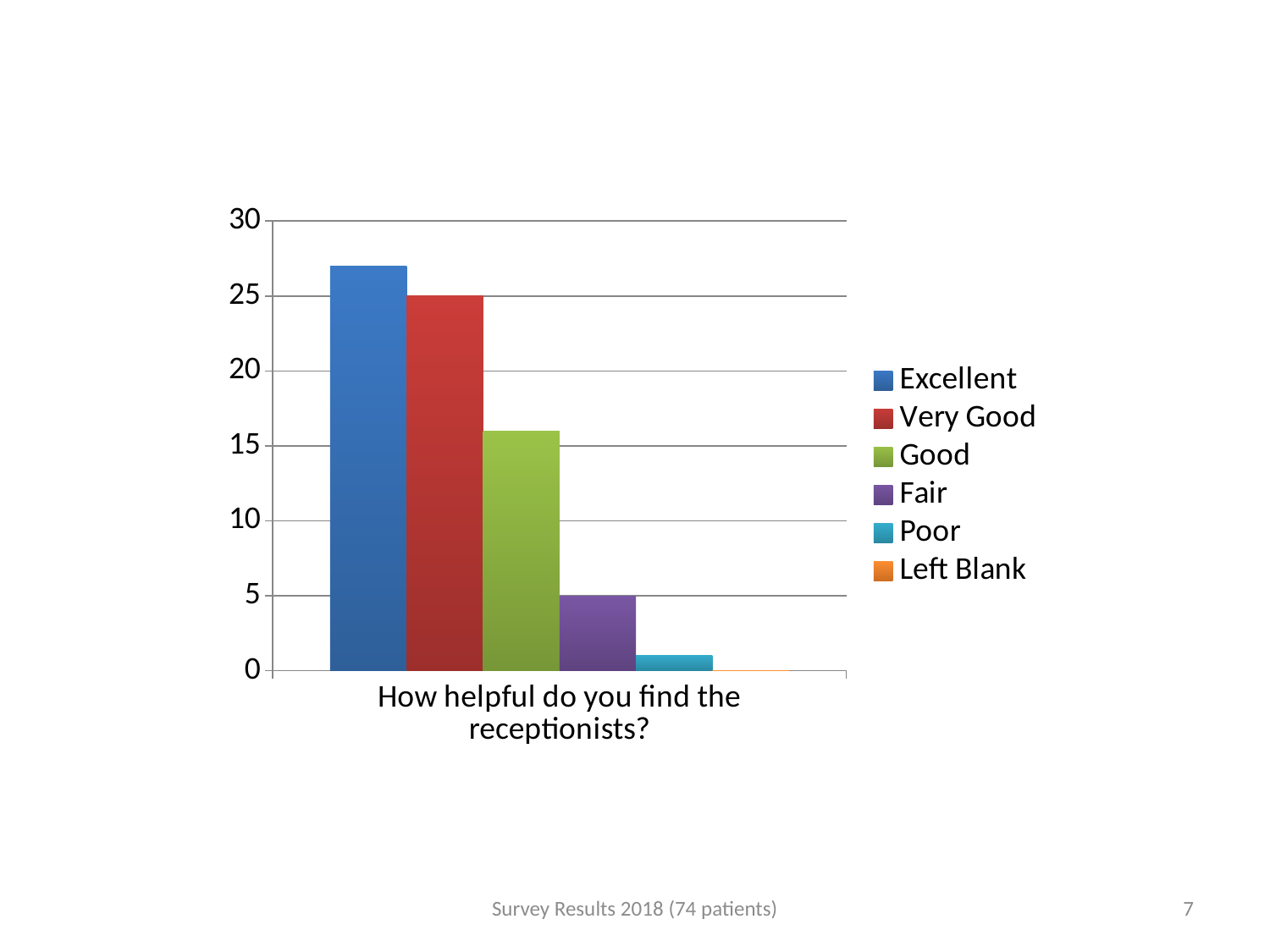
Which category has the highest value? Excellent What is the value for Fair? 5 Which is larger, the value for Excellent or the value for Very Good? Excellent Is the value for Excellent greater or less than 25? greater Which category has the lowest value? Left Blank How many series does the legend list? 6 What is the difference between the values for Very Good and Fair? 20 Is the value for Poor greater or less than 5? less Is the value for Good greater or less than 15? greater What kind of chart is shown on the slide? Bar chart What question is shown as the category label below the bars? How helpful do you find the receptionists? What is the value for Very Good? 25